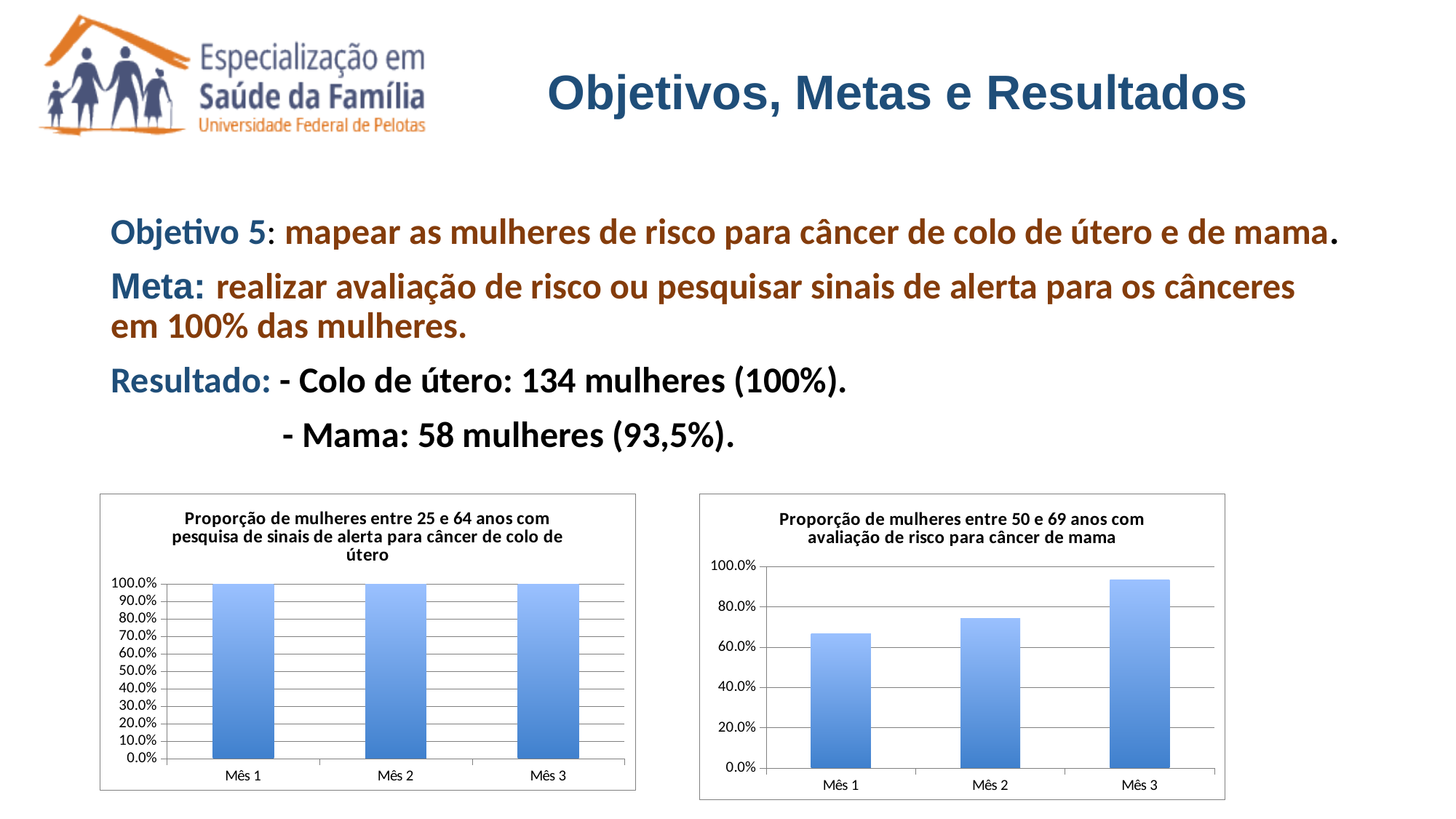
In the right chart (Proporção de mulheres entre 50 e 69 anos), is the value for Mês 1 greater or less than 80.0%? less What kind of chart is the right chart (Proporção de mulheres entre 50 e 69 anos)? bar chart In the right chart (Proporção de mulheres entre 50 e 69 anos), which month has the highest value? Mês 3 In the left chart (Proporção de mulheres entre 25 e 64 anos), how many categories are shown on the x axis? 3 In the left chart (Proporção de mulheres entre 25 e 64 anos), what is the value for Mês 1? 100.0% In the left chart (Proporção de mulheres entre 25 e 64 anos), do the values rise, fall or stay the same from Mês 1 to Mês 3? stay the same In the right chart (Proporção de mulheres entre 50 e 69 anos), is the value for Mês 2 greater or less than 60.0%? greater In the left chart (Proporção de mulheres entre 25 e 64 anos), what is the value for Mês 3? 100.0% In the right chart (Proporção de mulheres entre 50 e 69 anos), which month has the lowest value? Mês 1 In the right chart (Proporção de mulheres entre 50 e 69 anos), do the values rise or fall from Mês 1 to Mês 3? rise In the right chart (Proporção de mulheres entre 50 e 69 anos), is the value for Mês 3 greater or less than 80.0%? greater What is the title of the right chart? Proporção de mulheres entre 50 e 69 anos com avaliação de risco para câncer de mama